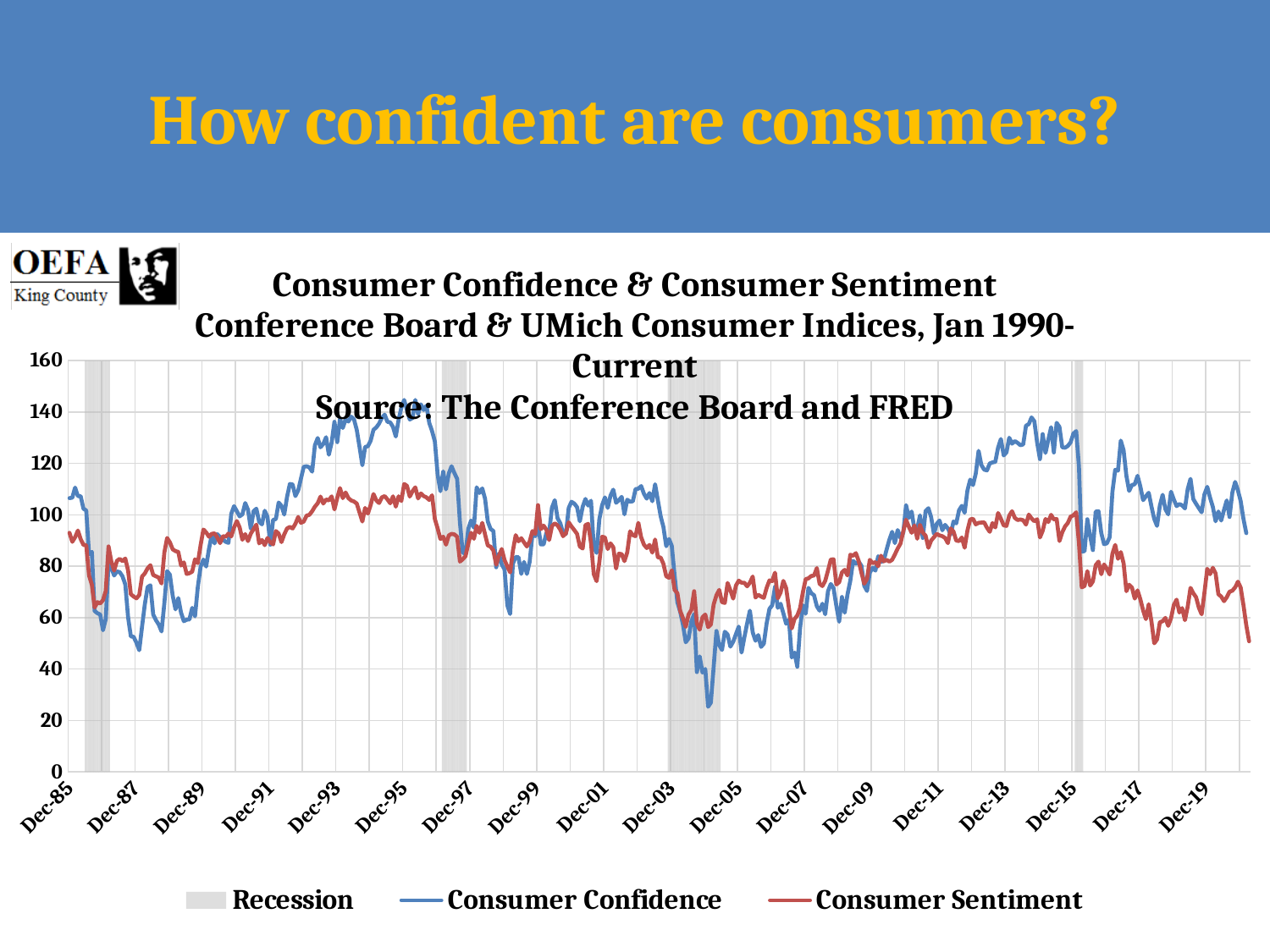
What type of chart is shown on the slide? Line chart Is the highest value reached by the Consumer Sentiment line greater or less than 120? less Which series has the lower value at the far right end of the chart, Consumer Confidence or Consumer Sentiment? Consumer Sentiment Which two data series are plotted as lines in the chart? Consumer Confidence and Consumer Sentiment Which series reaches the higher peak value over the whole chart, Consumer Confidence or Consumer Sentiment? Consumer Confidence What colour is the Consumer Sentiment line? Red Is the lowest value reached by the Consumer Confidence line greater or less than 40? less Is the value of Consumer Sentiment at the far right end of the chart greater or less than 60? less How many entries does the chart legend list? 3 Does the Consumer Confidence line generally rise or fall between Dec-09 and Dec-13? Rise How many date labels are shown on the x axis? 18